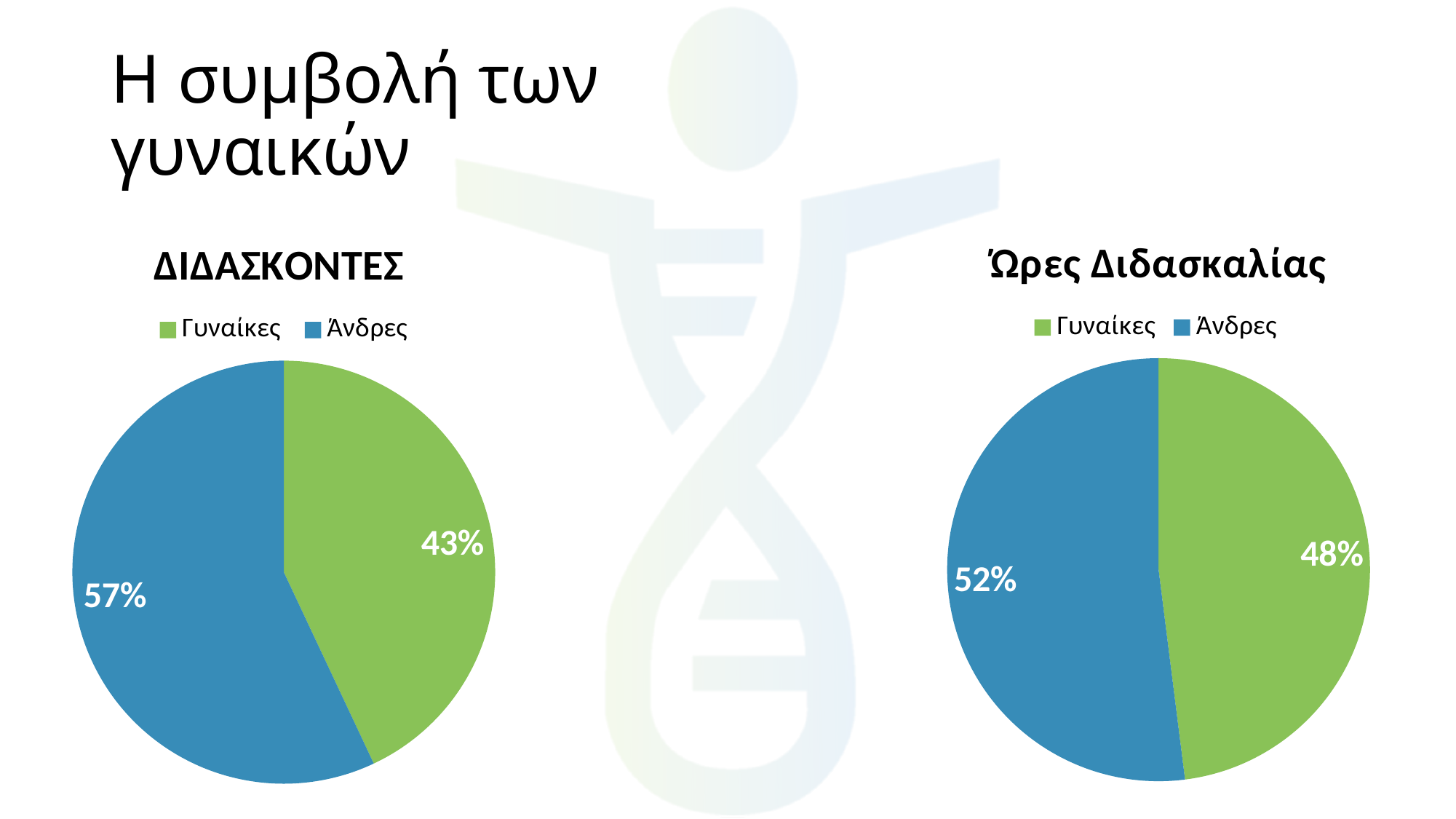
In the ΔΙΔΑΣΚΟΝΤΕΣ chart, what percentage is shown for Γυναίκες? 43% In the ΔΙΔΑΣΚΟΝΤΕΣ chart, which category has the larger share? Άνδρες What type of chart is the ΔΙΔΑΣΚΟΝΤΕΣ chart? Pie chart Is the share for Γυναίκες larger in the ΔΙΔΑΣΚΟΝΤΕΣ chart or in the Ώρες Διδασκαλίας chart? Ώρες Διδασκαλίας In the Ώρες Διδασκαλίας chart, what is the difference in percentage points between Άνδρες and Γυναίκες? 4 In the Ώρες Διδασκαλίας chart, which category has the smaller share? Γυναίκες In the ΔΙΔΑΣΚΟΝΤΕΣ chart, which colour represents Γυναίκες? Green In the ΔΙΔΑΣΚΟΝΤΕΣ chart, what percentage is shown for Άνδρες? 57% In the ΔΙΔΑΣΚΟΝΤΕΣ chart, what is the difference in percentage points between Άνδρες and Γυναίκες? 14 In the Ώρες Διδασκαλίας chart, what percentage is shown for Γυναίκες? 48% In the Ώρες Διδασκαλίας chart, what percentage is shown for Άνδρες? 52% How many slices does the Ώρες Διδασκαλίας pie chart have? 2